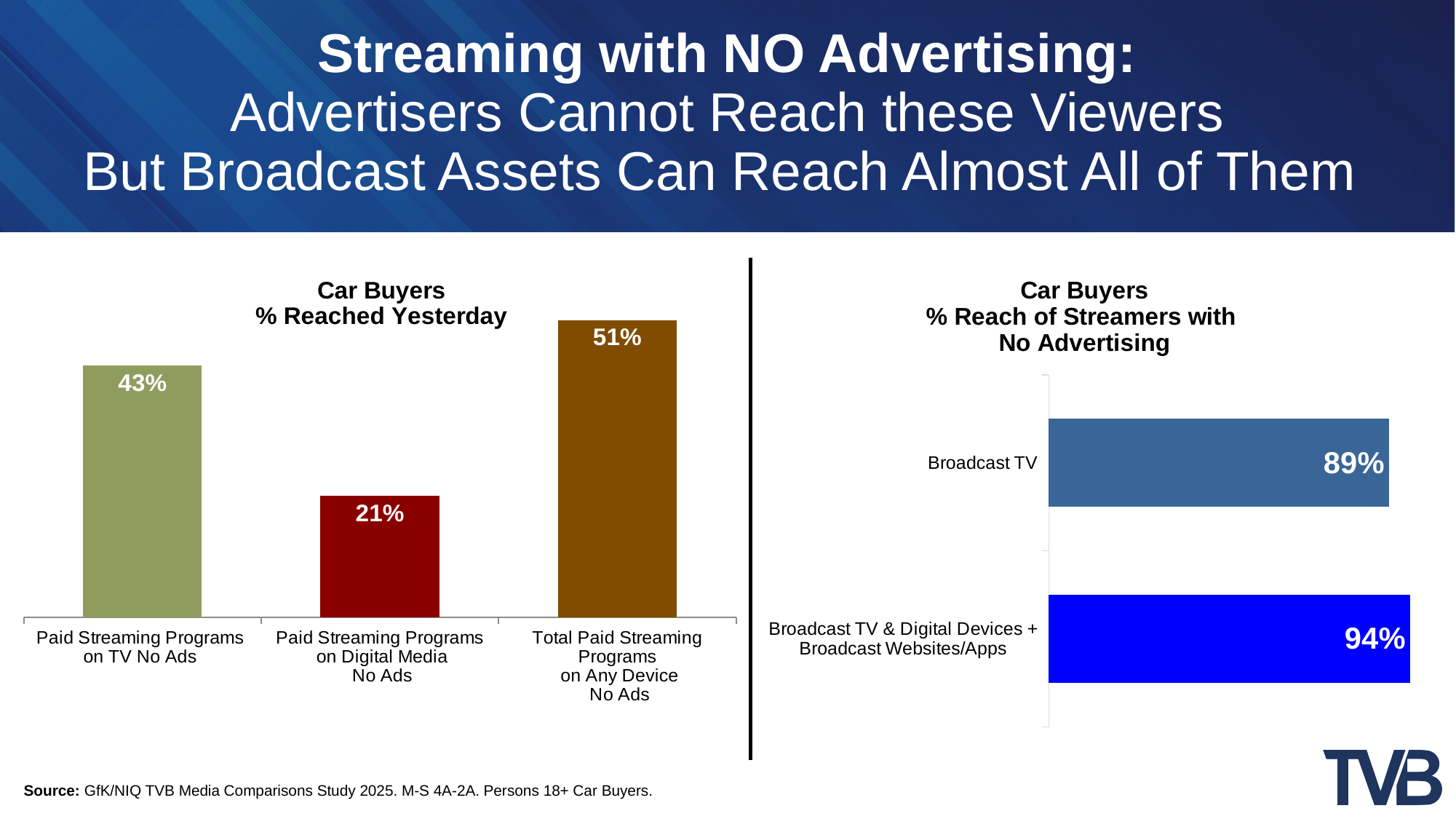
In the 'Car Buyers % Reach of Streamers with No Advertising' chart, which category is larger: Broadcast TV or Broadcast TV & Digital Devices + Broadcast Websites/Apps? Broadcast TV & Digital Devices + Broadcast Websites/Apps In the 'Car Buyers % Reach of Streamers with No Advertising' chart, what is the difference between the two bars? 5% In the 'Car Buyers % Reached Yesterday' chart, what is the value for Paid Streaming Programs on Digital Media No Ads? 21% What kind of chart is the 'Car Buyers % Reach of Streamers with No Advertising' chart? Bar chart In the 'Car Buyers % Reached Yesterday' chart, what is the value for Paid Streaming Programs on TV No Ads? 43% In the 'Car Buyers % Reached Yesterday' chart, which category has the lowest value? Paid Streaming Programs on Digital Media No Ads In the 'Car Buyers % Reach of Streamers with No Advertising' chart, what colour is the Broadcast TV & Digital Devices + Broadcast Websites/Apps bar? Blue In the 'Car Buyers % Reach of Streamers with No Advertising' chart, what is the value for Broadcast TV? 89% In the 'Car Buyers % Reached Yesterday' chart, how many categories are shown? 3 In the 'Car Buyers % Reached Yesterday' chart, what is the difference between Total Paid Streaming Programs on Any Device No Ads and Paid Streaming Programs on TV No Ads? 8% In the 'Car Buyers % Reached Yesterday' chart, which category has the highest value? Total Paid Streaming Programs on Any Device No Ads In the 'Car Buyers % Reach of Streamers with No Advertising' chart, what is the value for Broadcast TV & Digital Devices + Broadcast Websites/Apps? 94%